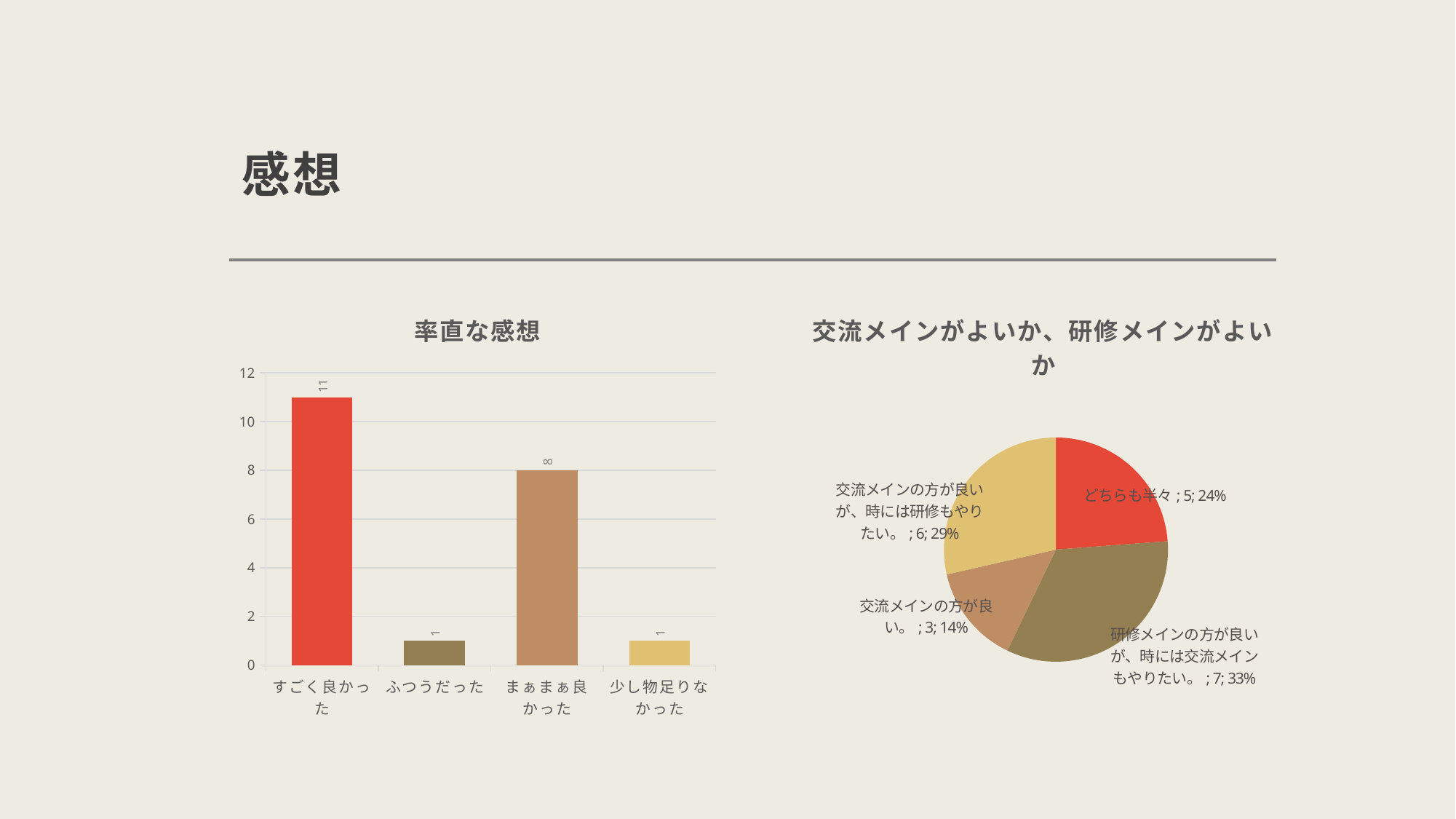
In the pie chart titled 交流メインがよいか、研修メインがよいか, what is the value for 交流メインの方が良い。? 3 In the pie chart titled 交流メインがよいか、研修メインがよいか, how many slices are there? 4 What kind of chart is the chart titled 率直な感想? bar chart What kind of chart is the chart titled 交流メインがよいか、研修メインがよいか? pie chart In the pie chart titled 交流メインがよいか、研修メインがよいか, what share does どちらも半々 have? 24% In the pie chart titled 交流メインがよいか、研修メインがよいか, which slice is the largest? 研修メインの方が良いが、時には交流メインもやりたい。 In the bar chart titled 率直な感想, what is the value for ふつうだった? 1 In the bar chart titled 率直な感想, how many categories are shown? 4 In the bar chart titled 率直な感想, what is the value for まぁまぁ良かった? 8 In the bar chart titled 率直な感想, which category has the highest value? すごく良かった In the bar chart titled 率直な感想, what is the value for すごく良かった? 11 In the bar chart titled 率直な感想, what is the difference between すごく良かった and まぁまぁ良かった? 3